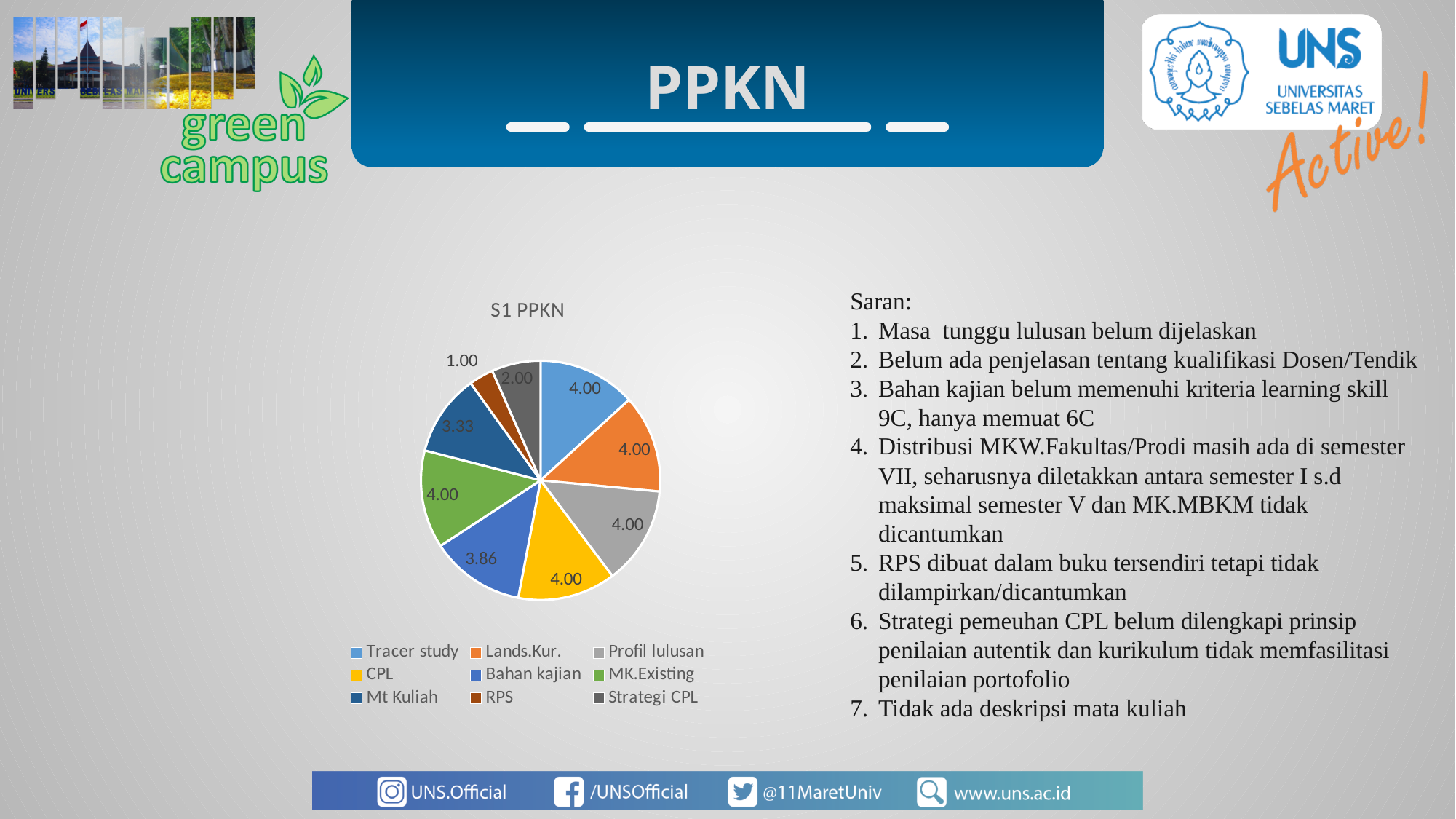
How many slices does the pie chart have? 9 What is the difference between the values for Bahan kajian and Mt Kuliah? 0.53 What type of chart is shown on the slide? Pie chart What is the value for Mt Kuliah? 3.33 What is the value for Tracer study? 4.00 What is the value for RPS? 1.00 What is the difference between the values for Strategi CPL and RPS? 1.00 Which category has the smallest slice? RPS Which is larger, the value for Mt Kuliah or the value for Strategi CPL? Mt Kuliah What is the value for Strategi CPL? 2.00 What is the title of the chart? S1 PPKN What is the value for Bahan kajian? 3.86